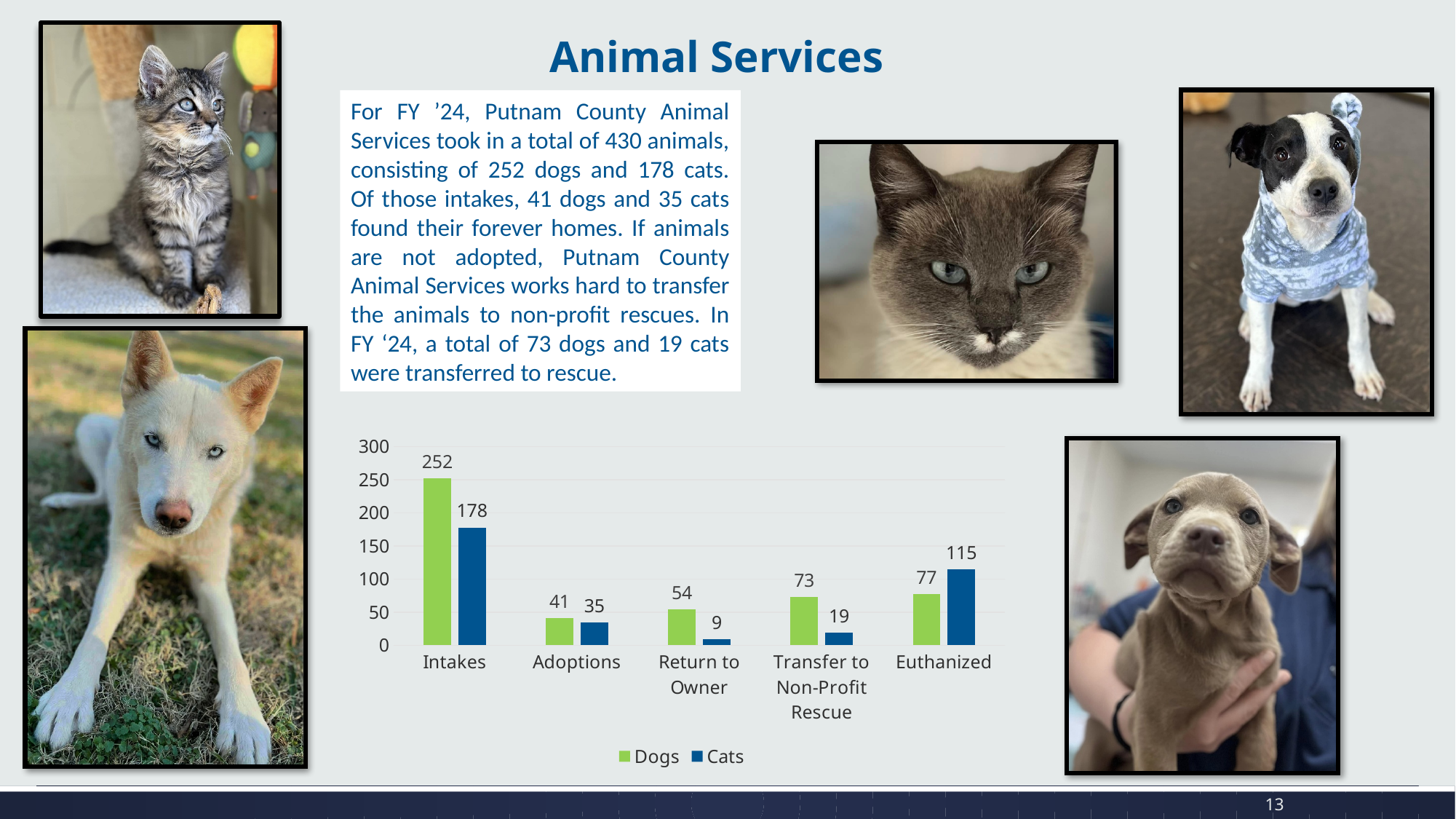
What is the difference between Dogs and Cats in the Intakes category? 74 Is the value for Dogs in the Adoptions category greater or less than 50? less How many categories are shown on the x axis of the chart? 5 What is the value for Cats in the Return to Owner category? 9 How many series does the chart legend list? 2 Which category has the highest value for Cats? Intakes What is the value for Cats in the Euthanized category? 115 What kind of chart is shown on the slide? bar chart What is the value for Dogs in the Intakes category? 252 Which is larger in the Euthanized category, Dogs or Cats? Cats Which category has the lowest value for Dogs? Adoptions What is the value for Dogs in the Transfer to Non-Profit Rescue category? 73